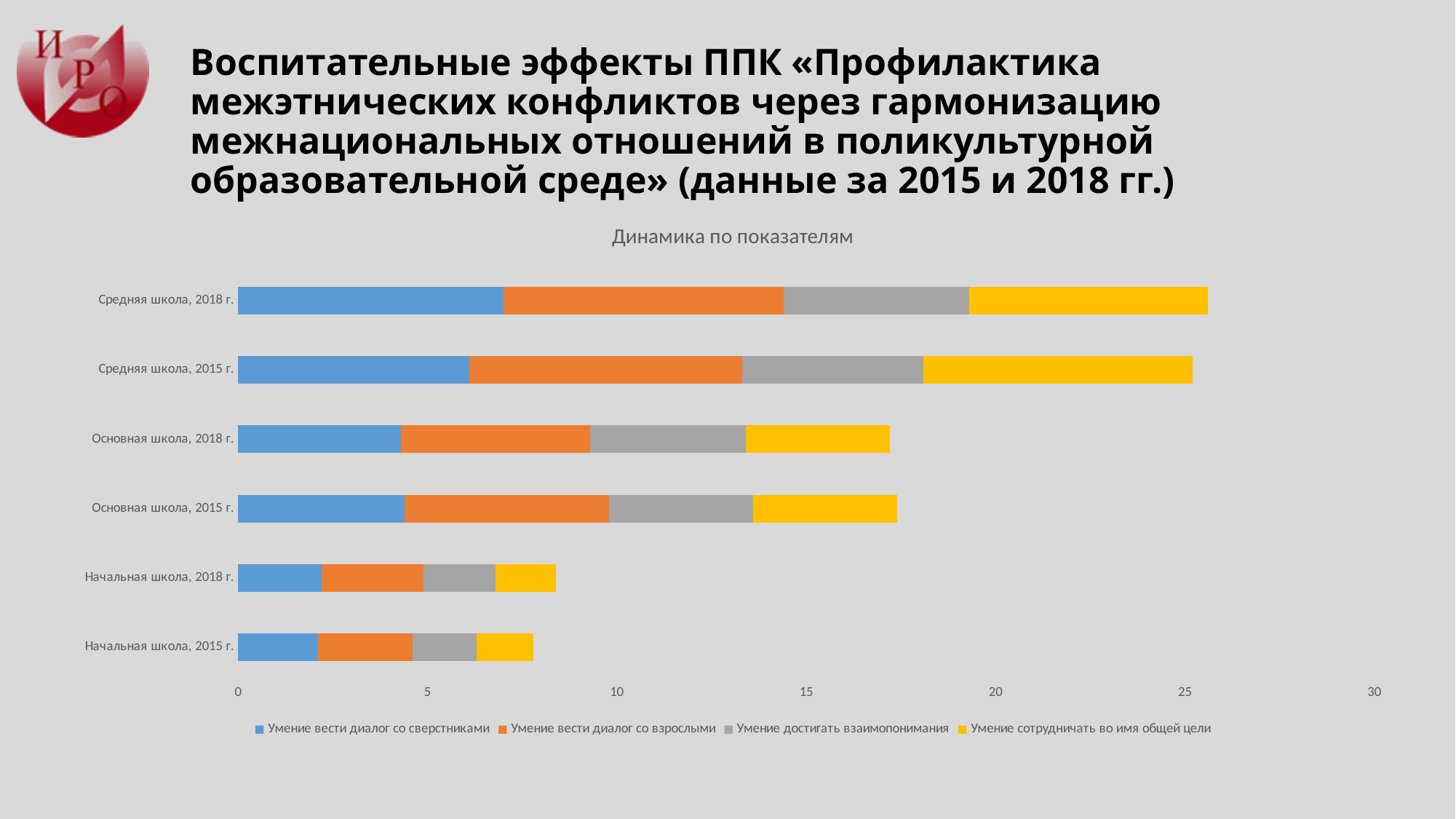
Is the value of Умение вести диалог со сверстниками for Средняя школа, 2018 г. greater or less than 5? greater How many categories (bars) does the chart show? 6 What kind of chart is shown on the slide? stacked bar chart How many series does the legend list? 4 Is the total length of the bar for Средняя школа, 2018 г. greater or less than 25? greater Which category has the shortest total bar? Начальная школа, 2015 г. Which series is shown in yellow in the legend? Умение сотрудничать во имя общей цели Is the value of Умение вести диалог со сверстниками for Начальная школа, 2015 г. greater or less than 5? less What is the title of the chart? Динамика по показателям Which has the larger total bar: Средняя школа, 2015 г. or Основная школа, 2015 г.? Средняя школа, 2015 г.